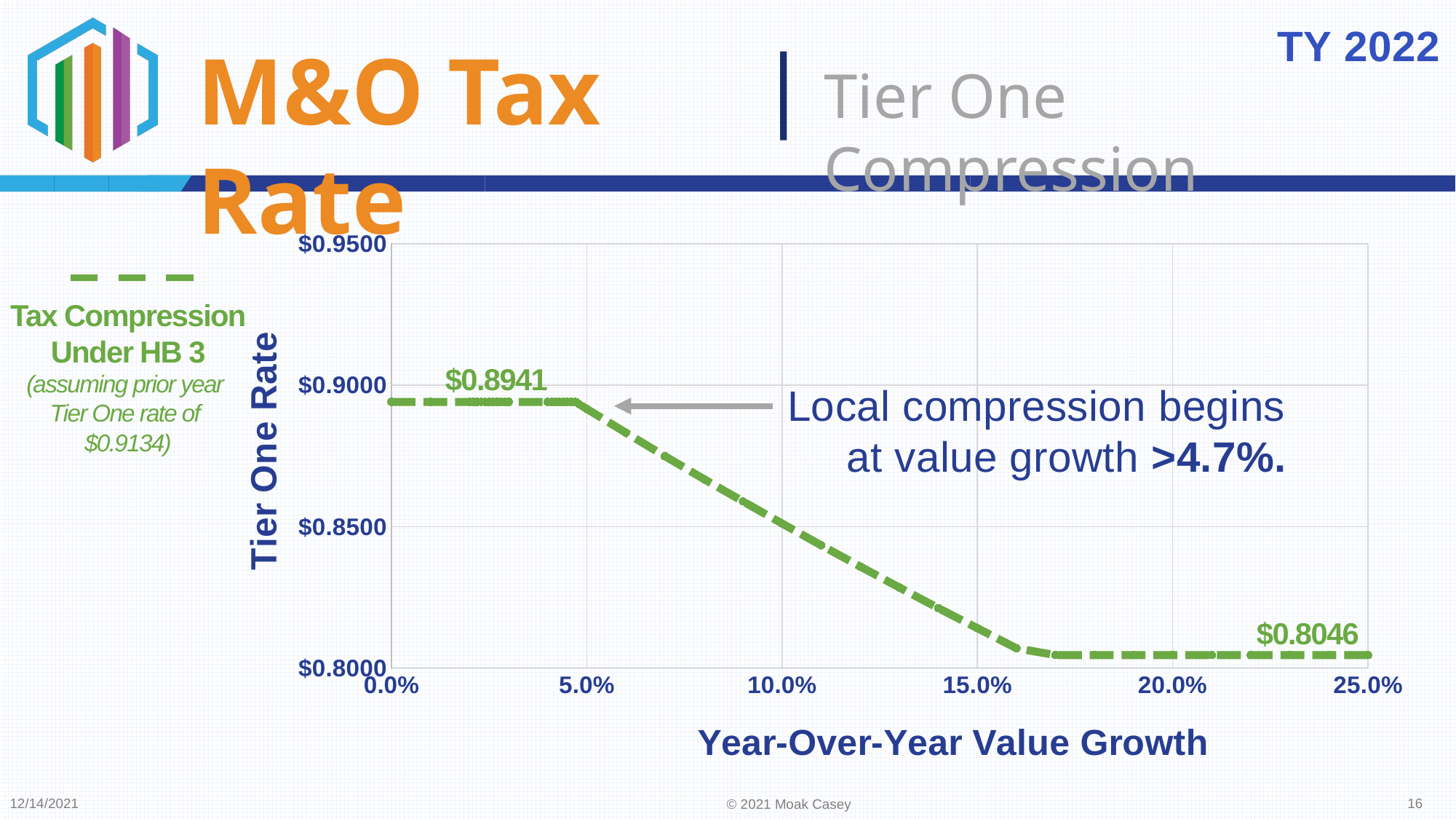
What is the Tier One Rate at 0.0% year-over-year value growth? $0.8941 What is the title of the chart's x axis? Year-Over-Year Value Growth What is the difference between the highest labelled Tier One Rate ($0.8941) and the lowest labelled Tier One Rate ($0.8046)? $0.0895 Is the Tier One Rate at 5.0% value growth greater or less than $0.8500? greater Is the Tier One Rate at 15.0% value growth greater or less than $0.8500? less What is the Tier One Rate at 25.0% year-over-year value growth? $0.8046 Does the Tier One Rate rise or fall as year-over-year value growth increases from 5.0% to 15.0%? fall What kind of chart is shown on the slide? line chart Is the Tier One Rate at 0.0% value growth larger or smaller than the rate at 25.0% value growth? larger What is the highest Tier One Rate labelled on the chart? $0.8941 What is the lowest Tier One Rate labelled on the chart? $0.8046 How many series does the chart legend list? 1